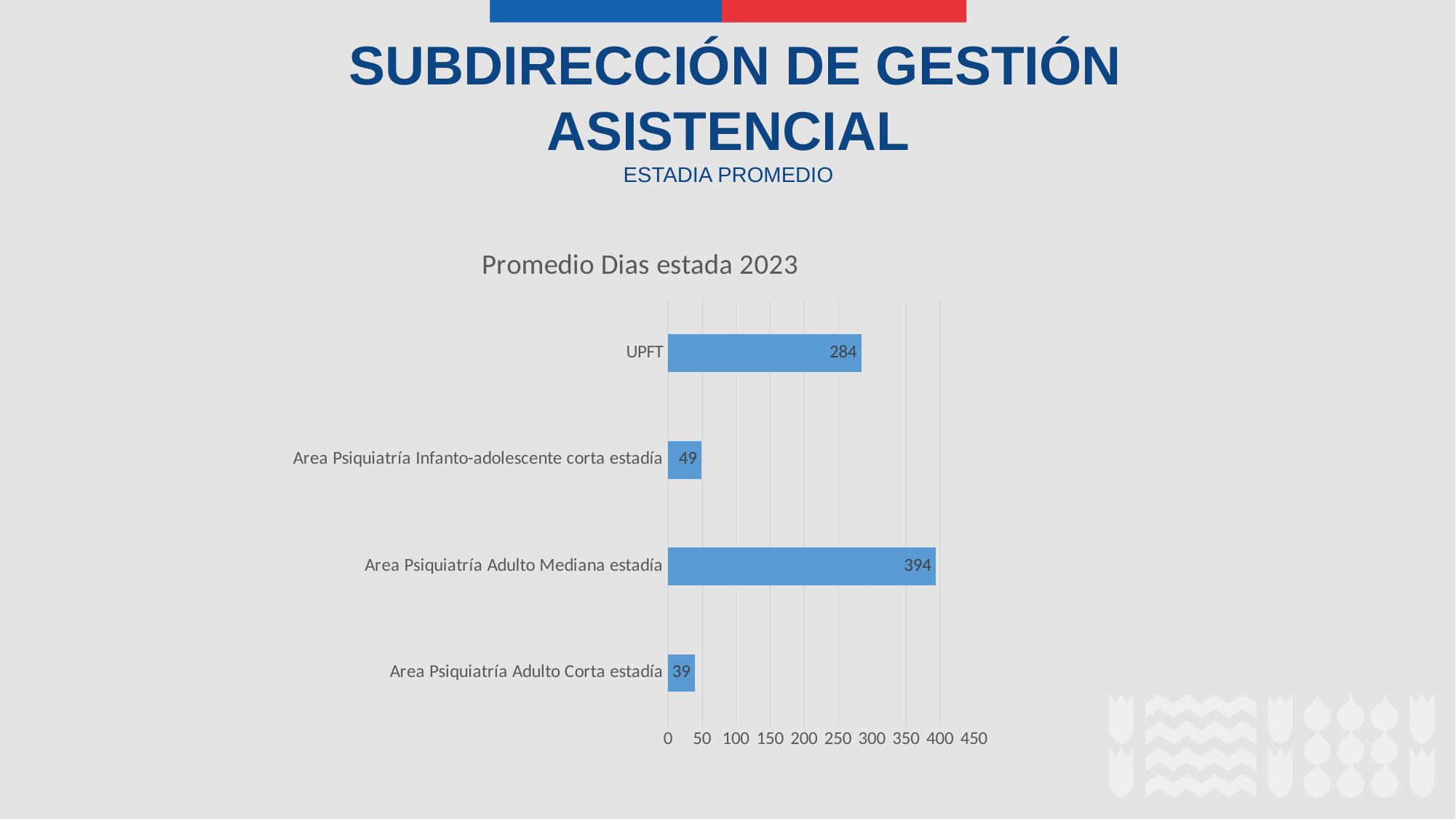
What is the value for Area Psiquiatría Adulto Corta estadía? 39 What is the value for Area Psiquiatría Infanto-adolescente corta estadía? 49 Which category has the lowest value? Area Psiquiatría Adulto Corta estadía What is the value for Area Psiquiatría Adulto Mediana estadía? 394 Which is larger, the value for UPFT or the value for Area Psiquiatría Adulto Mediana estadía? Area Psiquiatría Adulto Mediana estadía What is the value for UPFT? 284 What is the difference between the values for Area Psiquiatría Adulto Mediana estadía and UPFT? 110 What is the title of the chart? Promedio Dias estada 2023 What is the difference between the values for Area Psiquiatría Infanto-adolescente corta estadía and Area Psiquiatría Adulto Corta estadía? 10 What kind of chart is shown on the slide? Bar chart How many categories are shown in the chart? 4 Which category has the highest value? Area Psiquiatría Adulto Mediana estadía